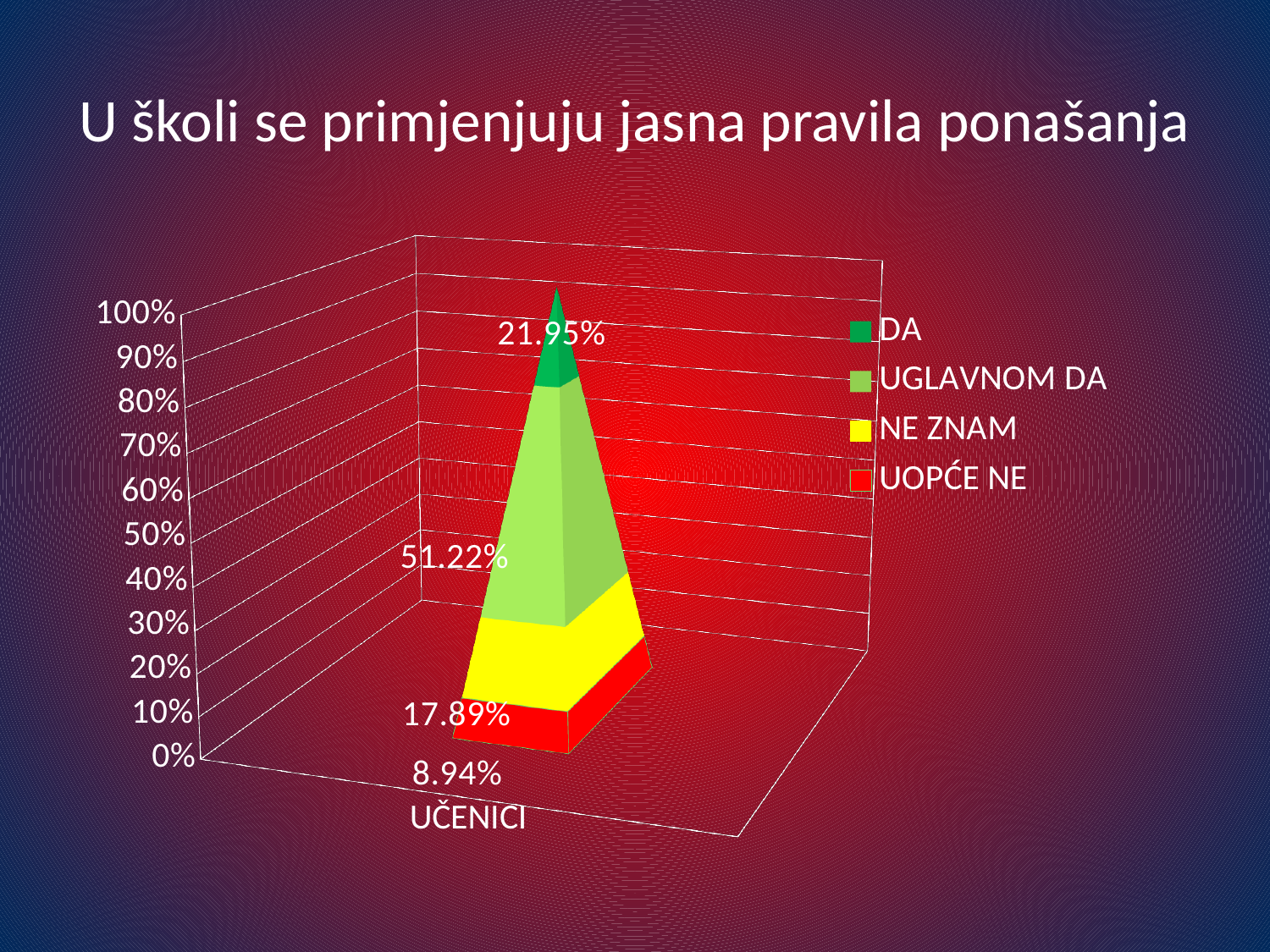
Which series has the highest value in the chart? UGLAVNOM DA What is the value for UOPĆE NE in the chart? 8.94% What is the value for UGLAVNOM DA in the chart? 51.22% What is the title of the slide containing the chart? U školi se primjenjuju jasna pravila ponašanja What is the total of the stacked bar for UČENICI? 100% How many series does the legend list? 4 Which series has the lowest value in the chart? UOPĆE NE What is the difference between the values for UGLAVNOM DA and DA? 29.27% What is the value for NE ZNAM in the chart? 17.89% How many categories are shown on the x axis of the chart? 1 Which is larger, the value for DA or the value for NE ZNAM? DA What is the value for DA in the chart? 21.95%